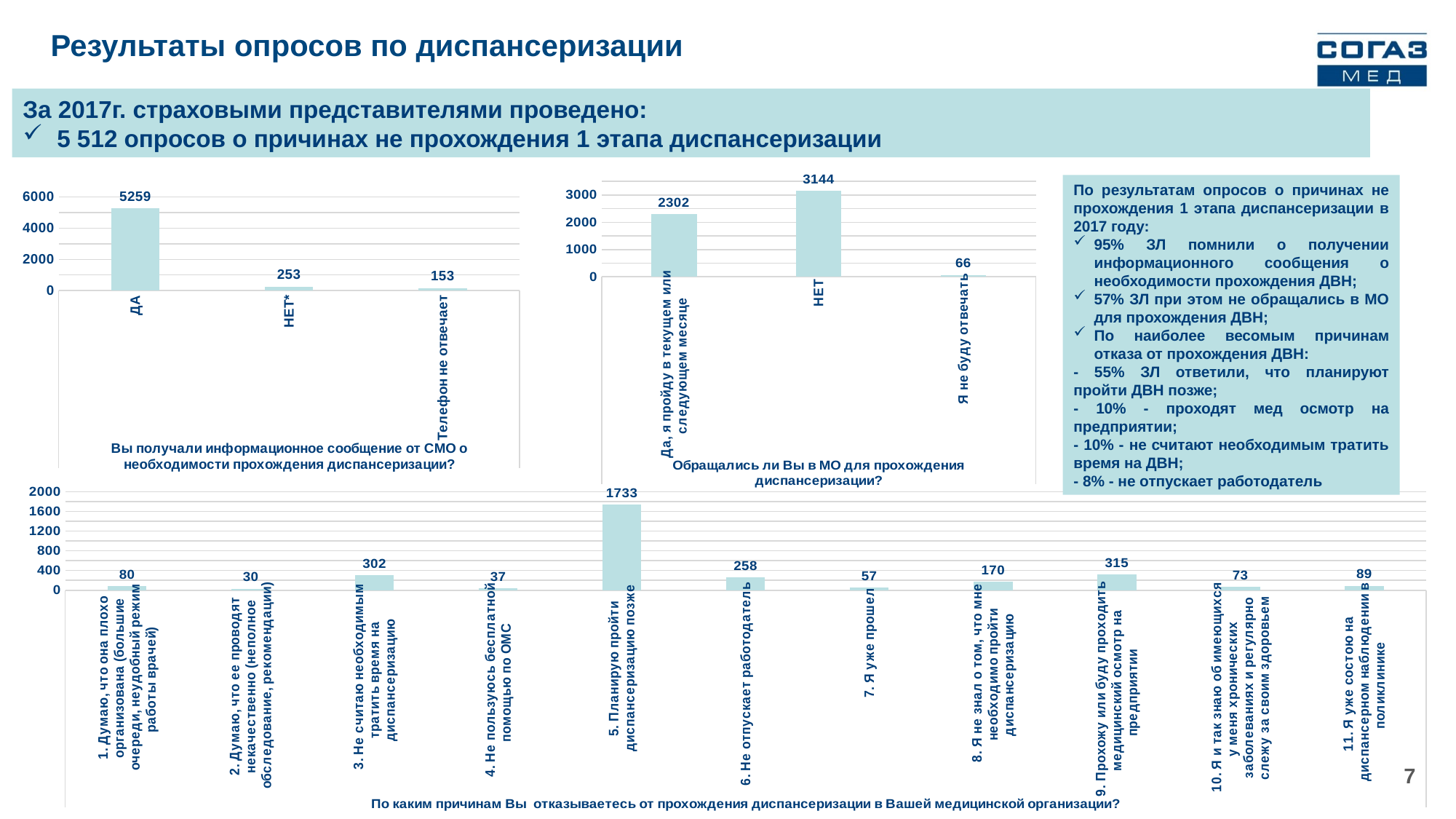
What type of chart is the bottom chart ("По каким причинам Вы отказываетесь...")? Bar chart In the bottom chart ("По каким причинам Вы отказываетесь..."), which category has the lowest value? 2. Думаю, что ее проводят некачественно (неполное обследование, рекомендации) In the top-right chart ("Обращались ли Вы в МО для прохождения диспансеризации?"), which is larger: "Да, я пройду в текущем или следующем месяце" or "НЕТ"? НЕТ In the top-left chart ("Вы получали информационное сообщение от СМО о необходимости прохождения диспансеризации?"), what is the value for "ДА"? 5259 In the top-right chart ("Обращались ли Вы в МО для прохождения диспансеризации?"), what is the value for "НЕТ"? 3144 In the bottom chart ("По каким причинам Вы отказываетесь..."), how many categories are shown? 11 In the top-right chart ("Обращались ли Вы в МО для прохождения диспансеризации?"), how many categories are shown? 3 In the top-left chart ("Вы получали информационное сообщение от СМО..."), which category has the lowest value? Телефон не отвечает In the bottom chart ("По каким причинам Вы отказываетесь..."), what is the value for "6. Не отпускает работодатель"? 258 In the top-left chart ("Вы получали информационное сообщение от СМО..."), what is the difference between the values for "НЕТ*" and "Телефон не отвечает"? 100 In the bottom chart ("По каким причинам Вы отказываетесь от прохождения диспансеризации..."), what is the value for "5. Планирую пройти диспансеризацию позже"? 1733 In the bottom chart ("По каким причинам Вы отказываетесь..."), what is the difference between "9. Прохожу или буду проходить медицинский осмотр на предприятии" and "3. Не считаю необходимым тратить время на диспансеризацию"? 13